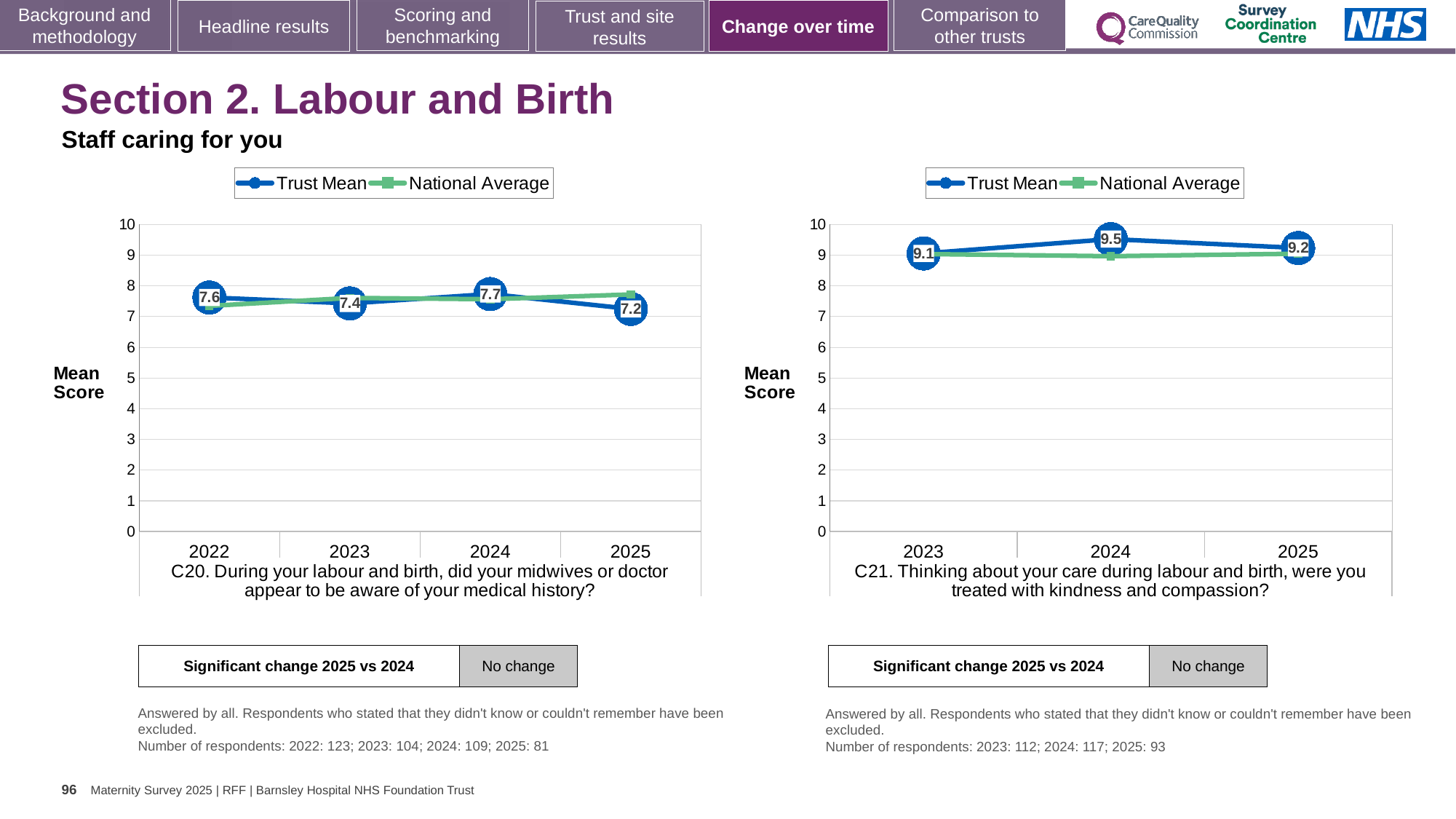
In the left chart (C20), what is the difference between the Trust Mean for 2024 and 2025? 0.5 In the left chart (C20), what is the Trust Mean for 2022? 7.6 How many years are plotted on the x axis of the right chart (C21)? 3 In the right chart (C21), is the Trust Mean for 2024 larger or smaller than the Trust Mean for 2025? larger What type of chart is the left chart (C20)? line chart In the left chart (C20), what is the Trust Mean for 2025? 7.2 How many series does the legend of the left chart (C20) list? 2 In the left chart (C20), which year has the lowest Trust Mean? 2025 In the right chart (C21), what is the difference between the Trust Mean for 2024 and 2023? 0.4 In the left chart (C20), which year has the highest Trust Mean? 2024 In the right chart (C21), which year has the lowest Trust Mean? 2023 In the right chart (C21), what is the Trust Mean for 2024? 9.5